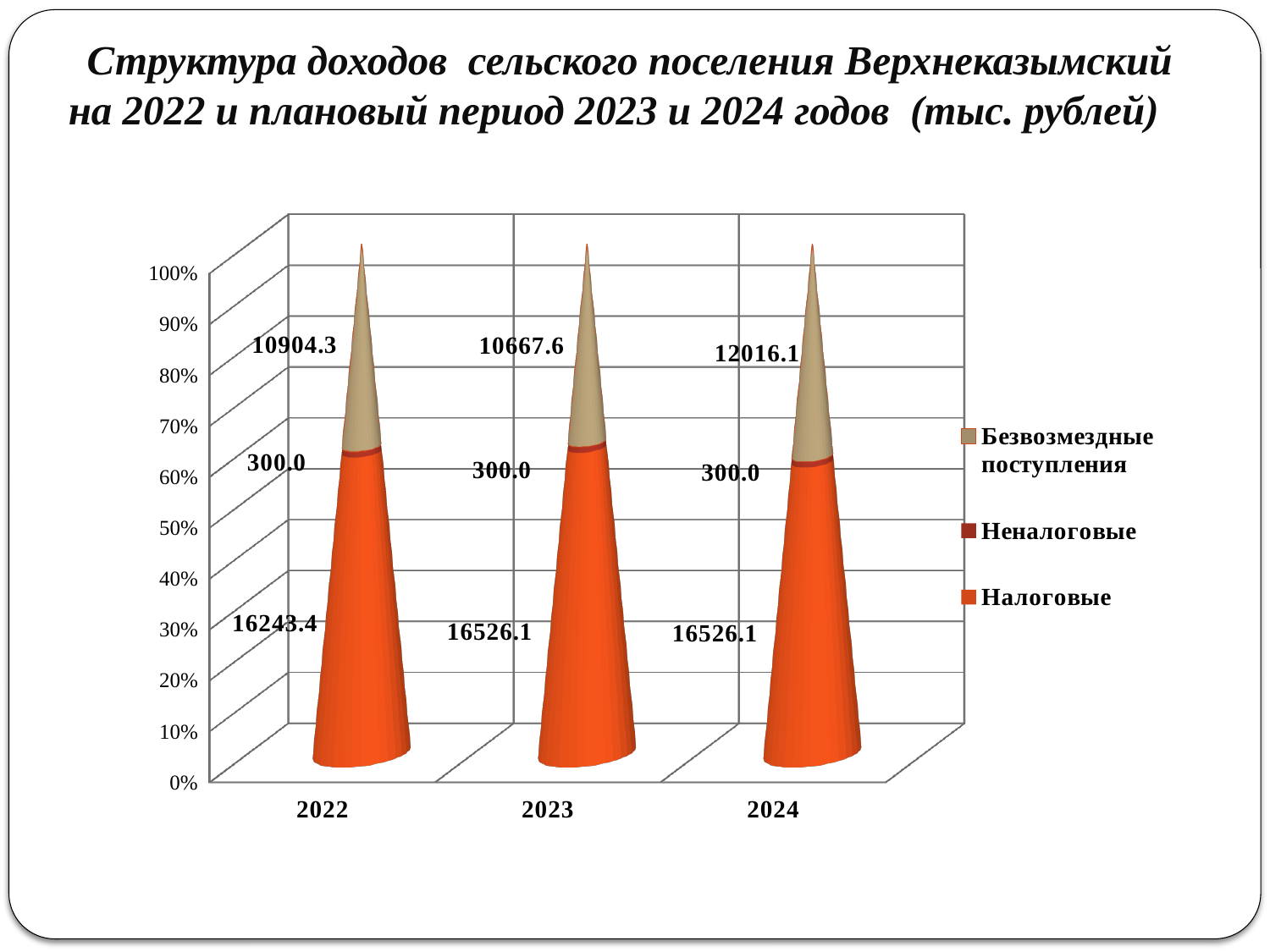
In which year is Безвозмездные поступления highest? 2024 In which year is Налоговые lowest? 2022 What is the difference between Налоговые in 2023 and in 2022? 282.7 In which year is Безвозмездные поступления lowest? 2023 What is the value of Налоговые for 2022? 16243.4 Which is larger, Безвозмездные поступления in 2022 or in 2023? 2022 What is the total of the three series for 2024? 28842.2 How many series does the legend list? 3 What is the difference between Безвозмездные поступления in 2024 and in 2023? 1348.5 What is the value of Безвозмездные поступления for 2024? 12016.1 What is the value of Неналоговые for 2023? 300.0 How many years are shown on the x axis? 3